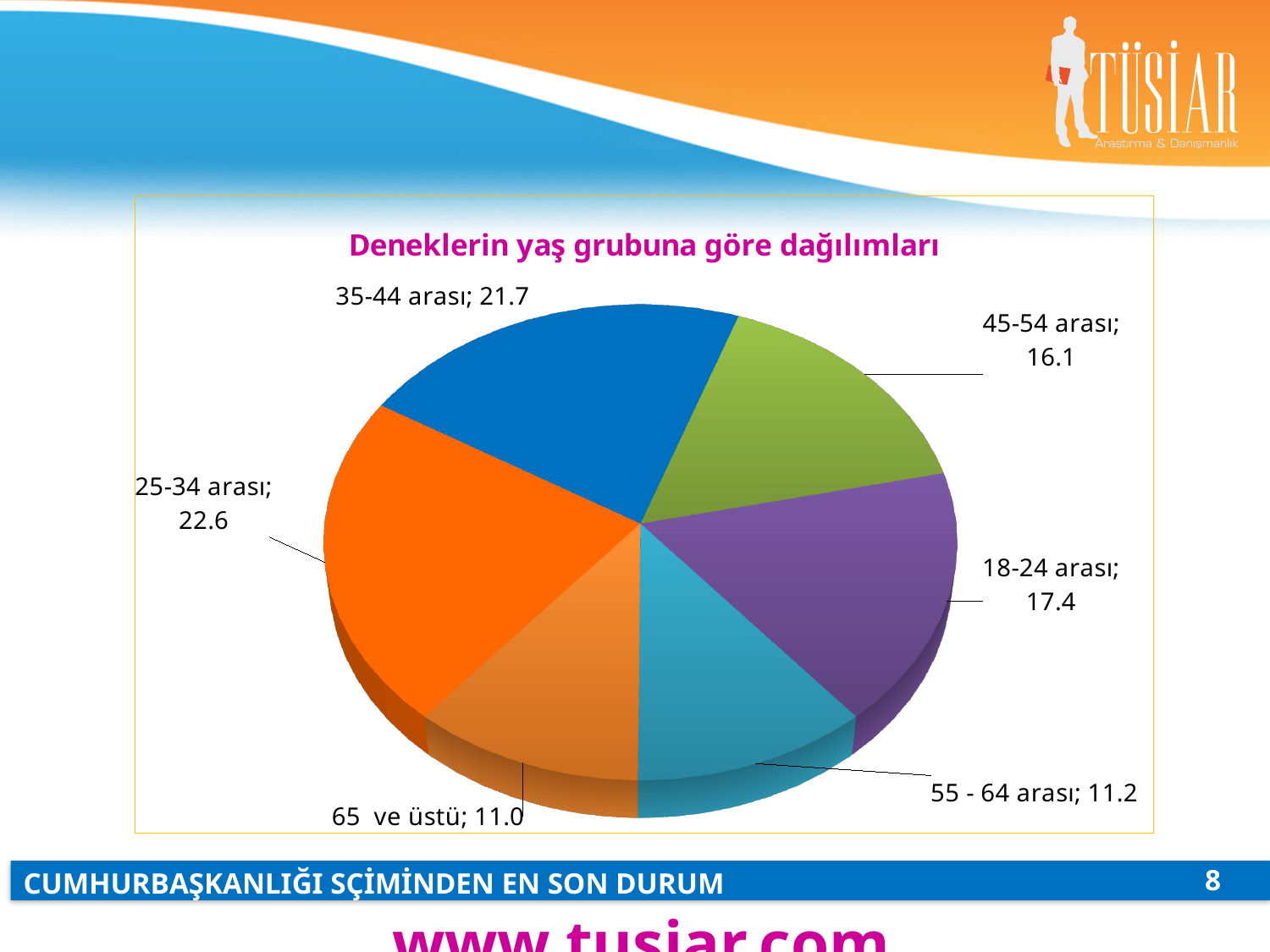
What type of chart is shown on the slide? Pie chart What is the value shown for the 45-54 arası slice? 16.1 Which age group has the largest slice of the pie? 25-34 arası Which age group has the smallest slice of the pie? 65 ve üstü How many age-group slices does the pie chart have? 6 What is the difference between the values for 35-44 arası and 65 ve üstü? 10.7 What is the title of the chart? Deneklerin yaş grubuna göre dağılımları What colour is the 25-34 arası slice? Orange What is the value shown for the 25-34 arası slice? 22.6 What is the difference between the values for 25-34 arası and 35-44 arası? 0.9 What is the value shown for the 55 - 64 arası slice? 11.2 Which is larger, the value for 18-24 arası or the value for 45-54 arası? 18-24 arası